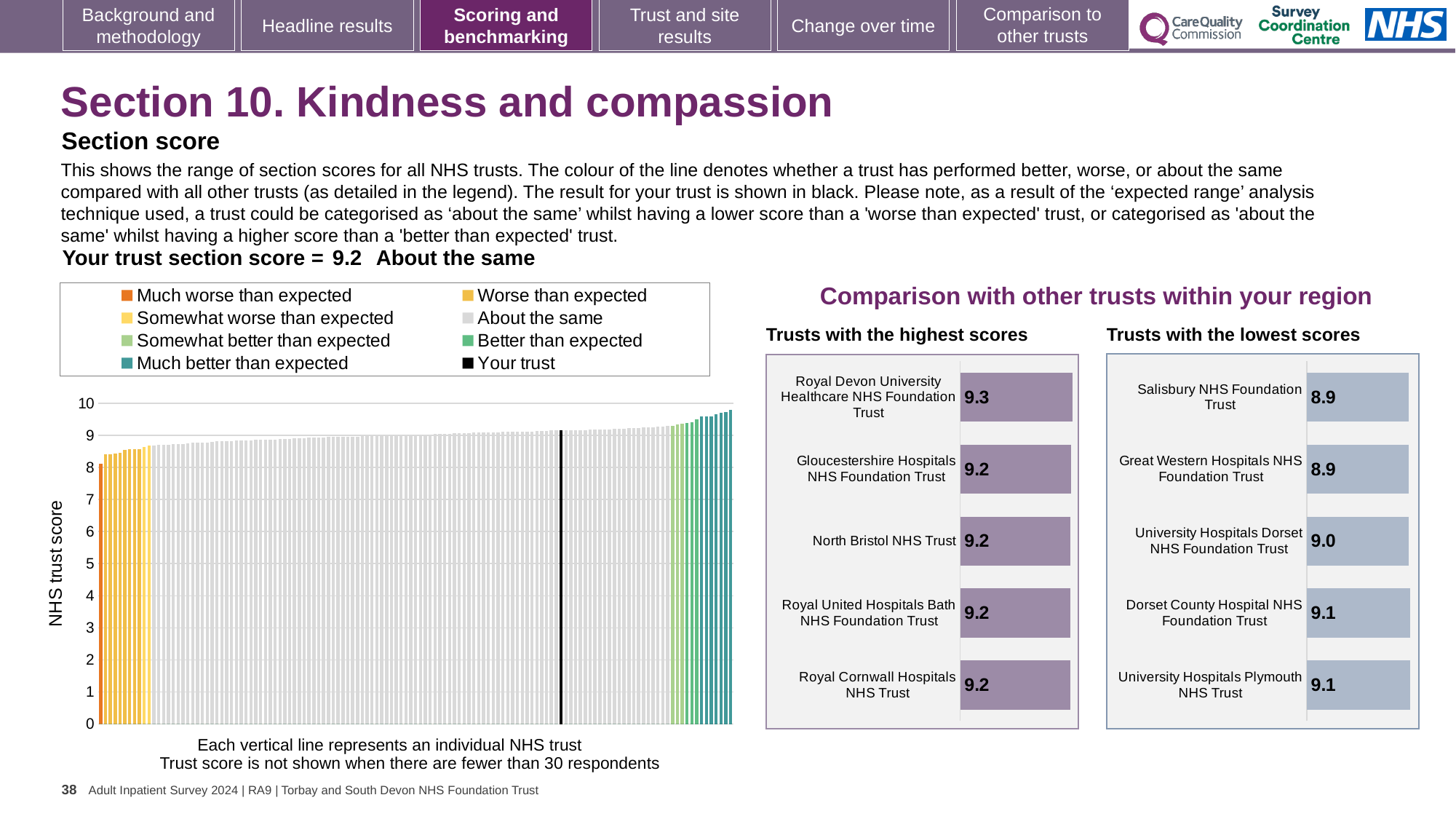
In the large chart on the left, what is the label on the vertical axis? NHS trust score In the large chart on the left, is the value of the highest (rightmost) bar greater or less than 10? less In the large chart on the left, how many entries does the legend list? 8 What kind of chart is the large chart on the left showing NHS trust scores? Bar chart In the 'Trusts with the lowest scores' chart, what is the score for University Hospitals Dorset NHS Foundation Trust? 9.0 In the 'Trusts with the lowest scores' chart, which has the larger score: University Hospitals Plymouth NHS Trust or Great Western Hospitals NHS Foundation Trust? University Hospitals Plymouth NHS Trust In the 'Trusts with the highest scores' chart, what is the score for Royal Devon University Healthcare NHS Foundation Trust? 9.3 In the 'Trusts with the highest scores' chart, which trust has the highest score? Royal Devon University Healthcare NHS Foundation Trust In the large chart on the left, do the trust scores rise or fall from left to right? Rise In the 'Trusts with the highest scores' chart, how many trusts are shown? 5 In the 'Trusts with the lowest scores' chart, what is the difference between the scores of Dorset County Hospital NHS Foundation Trust and Salisbury NHS Foundation Trust? 0.2